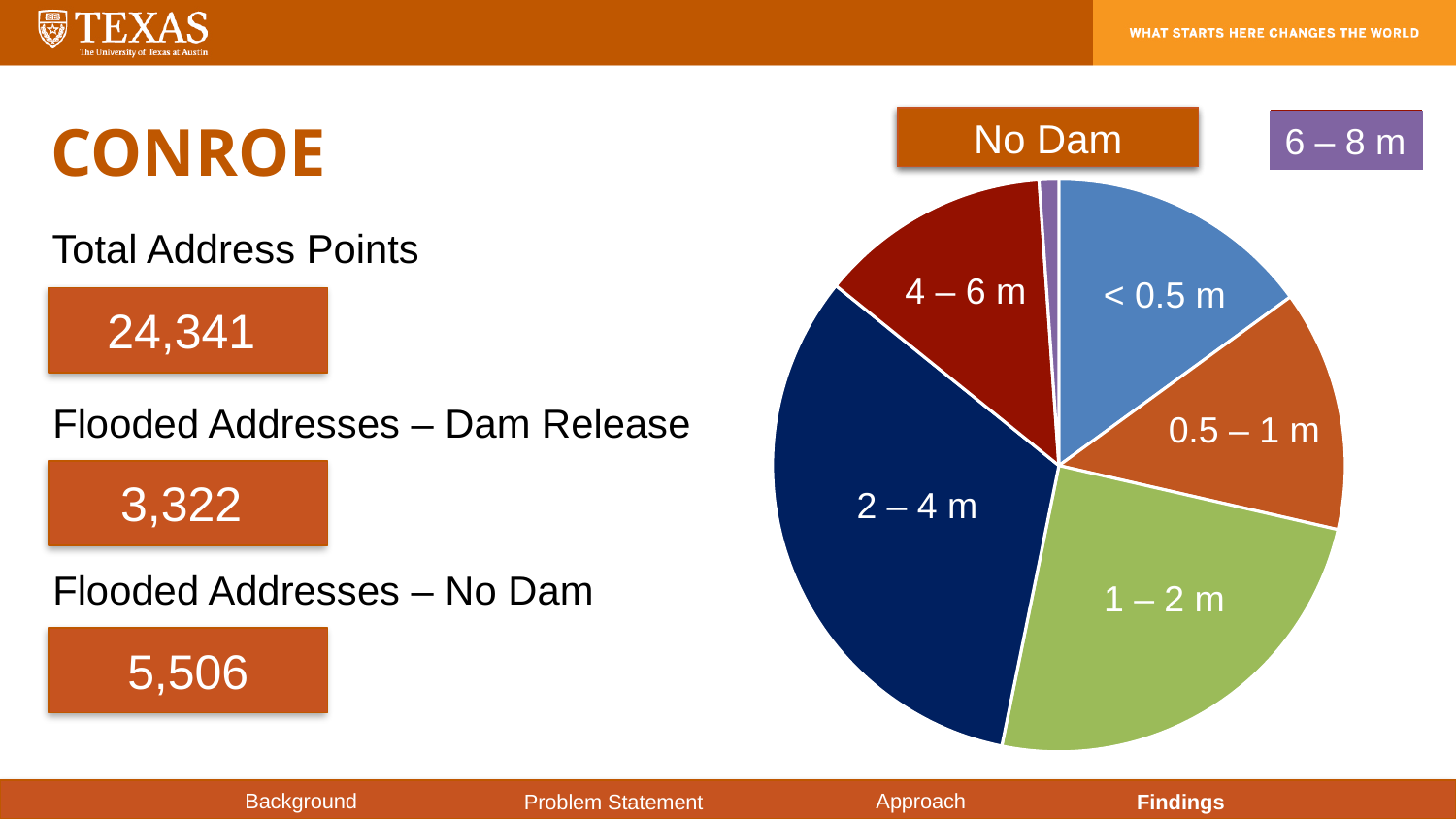
Which category has the largest slice in the pie chart? 2 – 4 m How many slices does the pie chart have? 6 What is the title of the pie chart? No Dam Which slice is larger, 1 – 2 m or 0.5 – 1 m? 1 – 2 m Which slice is larger, 2 – 4 m or 4 – 6 m? 2 – 4 m What kind of chart is shown on the slide? pie chart What colour is the 1 – 2 m slice in the pie chart? green Which category has the smallest slice in the pie chart? 6 – 8 m Which slice is larger, 2 – 4 m or < 0.5 m? 2 – 4 m